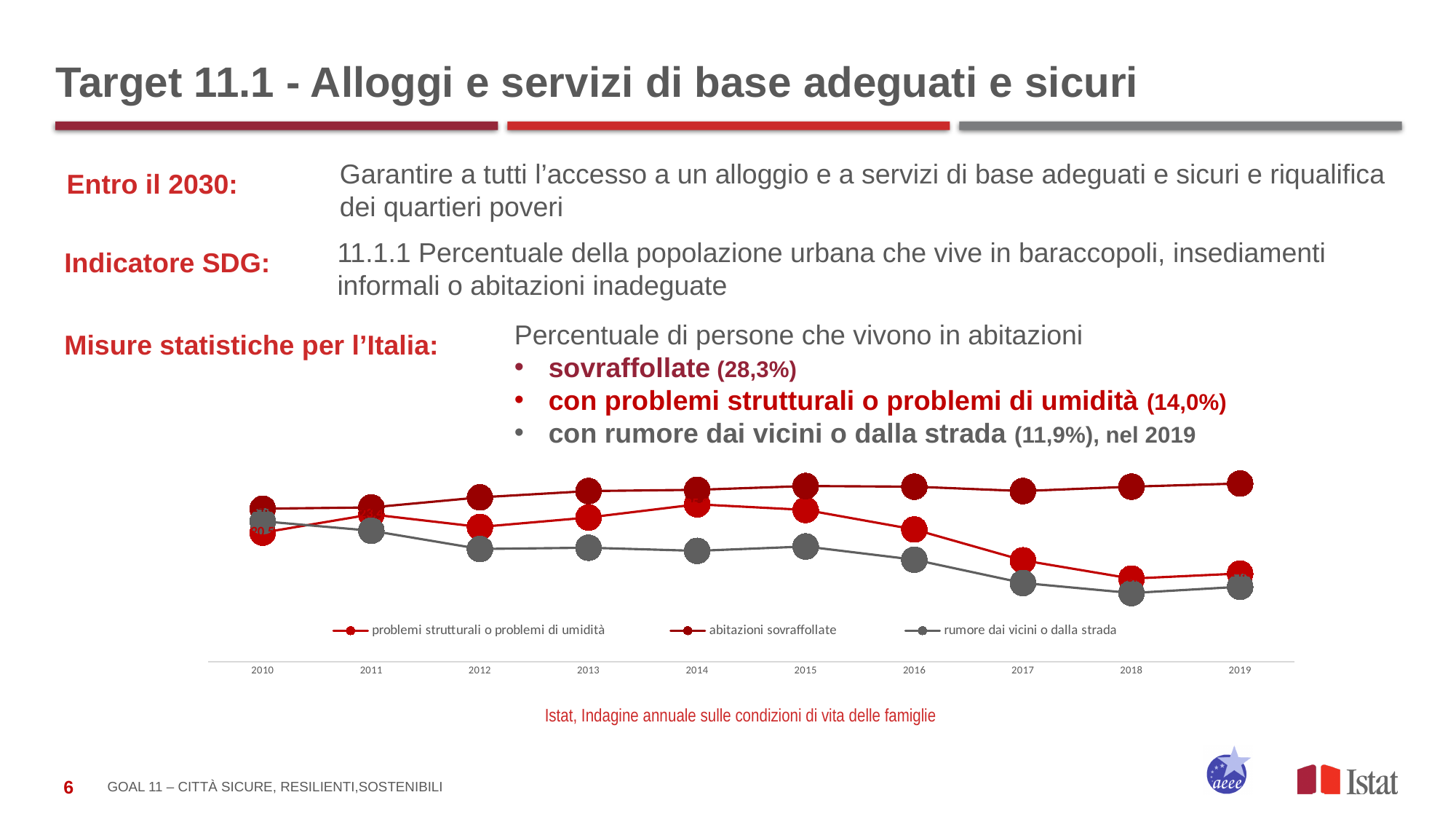
Does the 'rumore dai vicini o dalla strada' series rise or fall overall from 2010 to 2019? fall Does the 'abitazioni sovraffollate' series rise or fall overall from 2010 to 2019? rise What kind of chart is shown on the slide? line chart How many series does the chart legend list? 3 In 2019, which is larger: 'abitazioni sovraffollate' or 'rumore dai vicini o dalla strada'? abitazioni sovraffollate What is the last year shown on the x axis of the chart? 2019 How many years are shown on the x axis of the chart? 10 Does the 'problemi strutturali o problemi di umidità' series rise or fall from 2016 to 2019? fall What is the first year shown on the x axis of the chart? 2010 Which series has the highest value in 2019? abitazioni sovraffollate In 2016, which is larger: 'problemi strutturali o problemi di umidità' or 'rumore dai vicini o dalla strada'? problemi strutturali o problemi di umidità Which series has the lowest value in 2019? rumore dai vicini o dalla strada